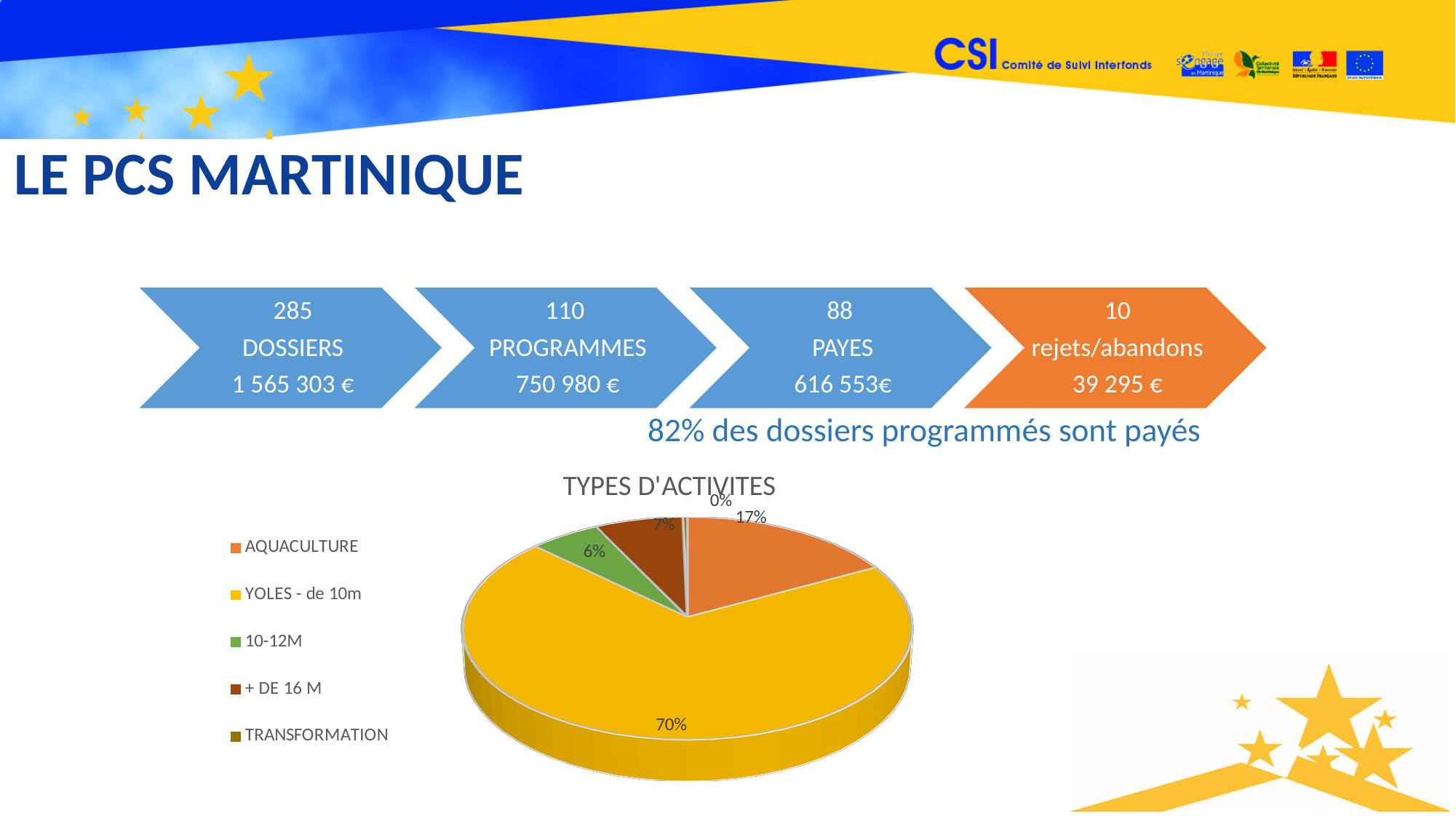
In the TYPES D'ACTIVITES pie chart, which is larger: AQUACULTURE or + DE 16 M? AQUACULTURE What type of chart is shown under the title TYPES D'ACTIVITES? Pie chart Which category has the smallest slice in the TYPES D'ACTIVITES pie chart? TRANSFORMATION Which category has the largest slice in the TYPES D'ACTIVITES pie chart? YOLES - de 10m What share of the TYPES D'ACTIVITES pie does YOLES - de 10m represent? 70% What share of the TYPES D'ACTIVITES pie does AQUACULTURE represent? 17% What share of the TYPES D'ACTIVITES pie does 10-12M represent? 6% In the TYPES D'ACTIVITES pie chart, what is the difference in percentage points between YOLES - de 10m and AQUACULTURE? 53 How many categories does the legend of the TYPES D'ACTIVITES pie chart list? 5 What is the title of the chart on the slide? TYPES D'ACTIVITES